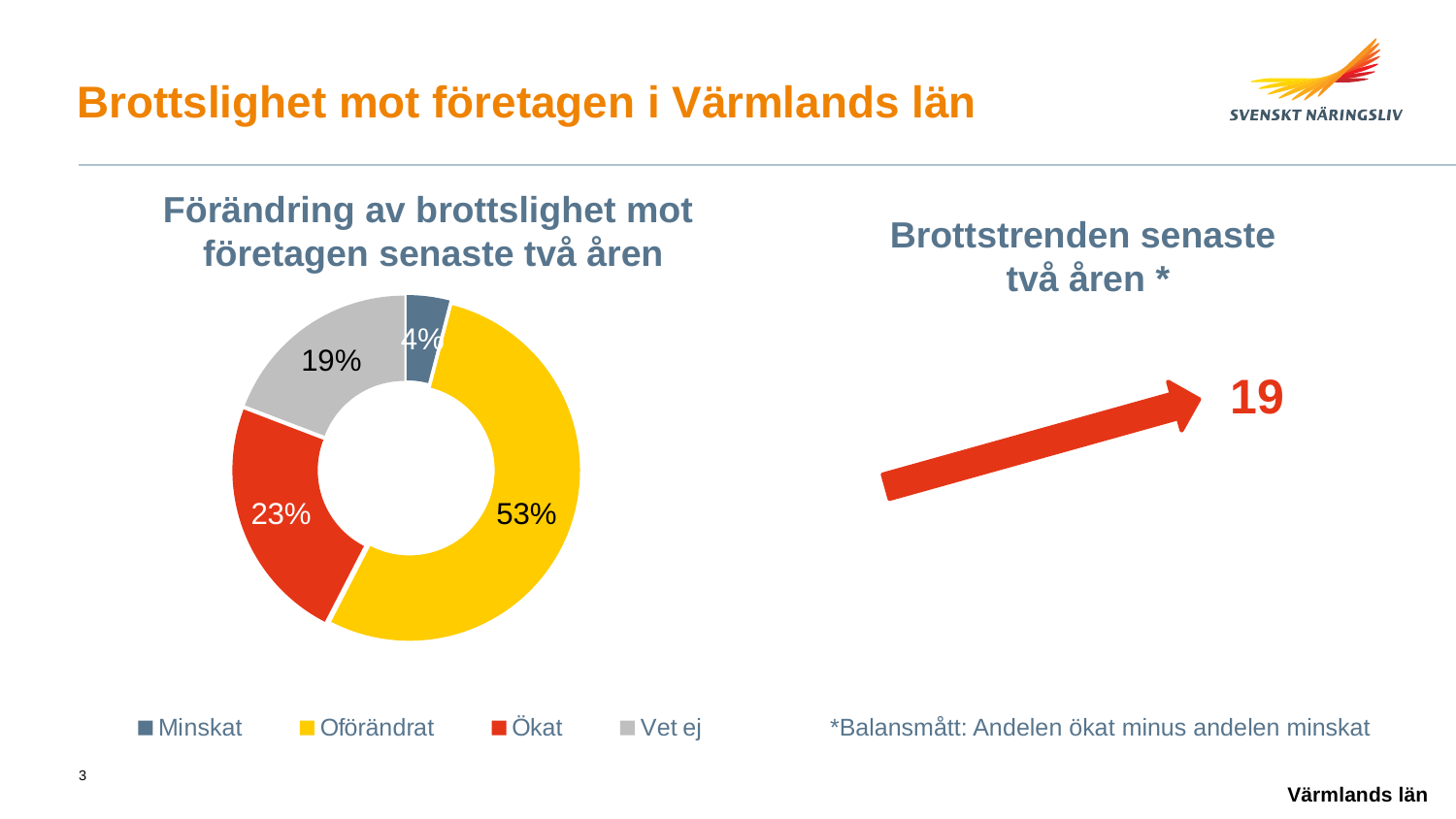
Which category has the largest slice in the chart 'Förändring av brottslighet mot företagen senaste två åren'? Oförändrat What kind of chart is 'Förändring av brottslighet mot företagen senaste två åren'? doughnut chart In the chart 'Förändring av brottslighet mot företagen senaste två åren', what colour is the Oförändrat slice? yellow How many categories are shown in the chart 'Förändring av brottslighet mot företagen senaste två åren'? 4 In the chart 'Förändring av brottslighet mot företagen senaste två åren', which is larger: Ökat or Vet ej? Ökat Which category has the smallest slice in the chart 'Förändring av brottslighet mot företagen senaste två åren'? Minskat In the chart 'Förändring av brottslighet mot företagen senaste två åren', what is the difference in percentage points between Ökat and Minskat? 19 What share of respondents answered Vet ej in the chart 'Förändring av brottslighet mot företagen senaste två åren'? 19% What is the combined share of Ökat and Minskat in the chart 'Förändring av brottslighet mot företagen senaste två åren'? 27% What share of respondents answered Oförändrat in the chart 'Förändring av brottslighet mot företagen senaste två åren'? 53% What share of respondents answered Ökat in the chart 'Förändring av brottslighet mot företagen senaste två åren'? 23% What share of respondents answered Minskat in the chart 'Förändring av brottslighet mot företagen senaste två åren'? 4%